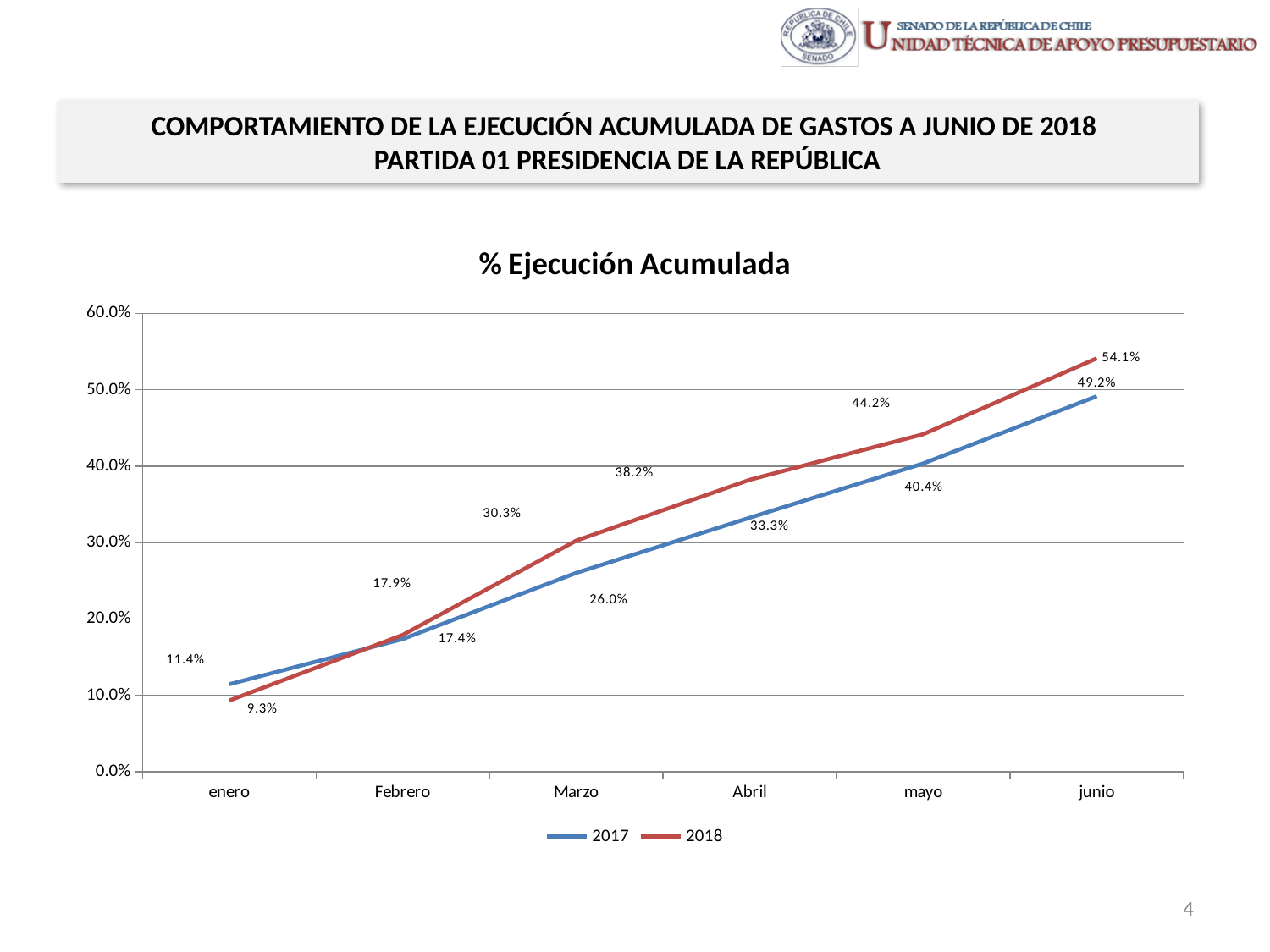
Which month has the lowest value for the 2018 series? enero What is the value for 2018 in enero? 9.3% Do the values for the 2018 series rise or fall from enero to junio? rise What type of chart is shown on the slide? line chart Which month has the highest value for the 2017 series? junio How many months are shown on the x axis? 6 What is the difference between the 2018 and 2017 values in junio? 4.9% In enero, which series has the larger value, 2017 or 2018? 2017 What is the value for 2017 in Marzo? 26.0% How many series does the legend list? 2 What is the title of the chart? % Ejecución Acumulada What is the value for 2018 in junio? 54.1%